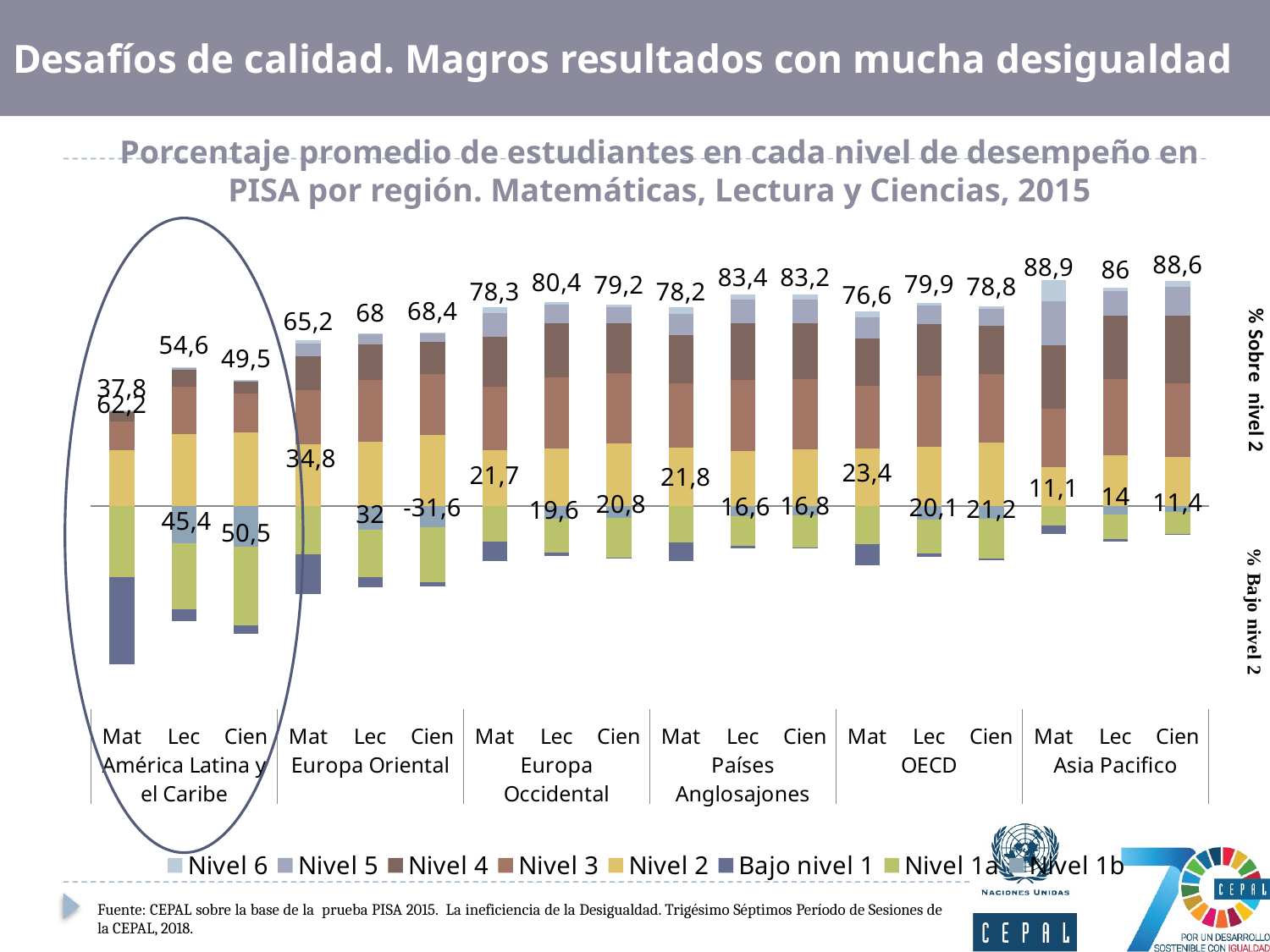
Which bar has the lowest % Sobre nivel 2 value? Mat, América Latina y el Caribe (37,8) What is the title of the chart? Porcentaje promedio de estudiantes en cada nivel de desempeño en PISA por región. Matemáticas, Lectura y Ciencias, 2015 What kind of chart is shown on the slide? Stacked bar chart How many series does the legend list? 8 What is the % Bajo nivel 2 value for Mat in América Latina y el Caribe? 62,2 What is the difference between the % Sobre nivel 2 values for Lec in Asia Pacifico and Lec in América Latina y el Caribe? 31,4 What is the % Sobre nivel 2 value for Mat in América Latina y el Caribe? 37,8 Which has a larger % Sobre nivel 2 value for Lec: Países Anglosajones or Europa Occidental? Países Anglosajones What is the % Sobre nivel 2 value for Lec in OECD? 79,9 What is the % Bajo nivel 2 value for Cien in Asia Pacifico? 11,4 How many regions are shown on the x axis? 6 Which bar has the highest % Sobre nivel 2 value? Mat, Asia Pacifico (88,9)